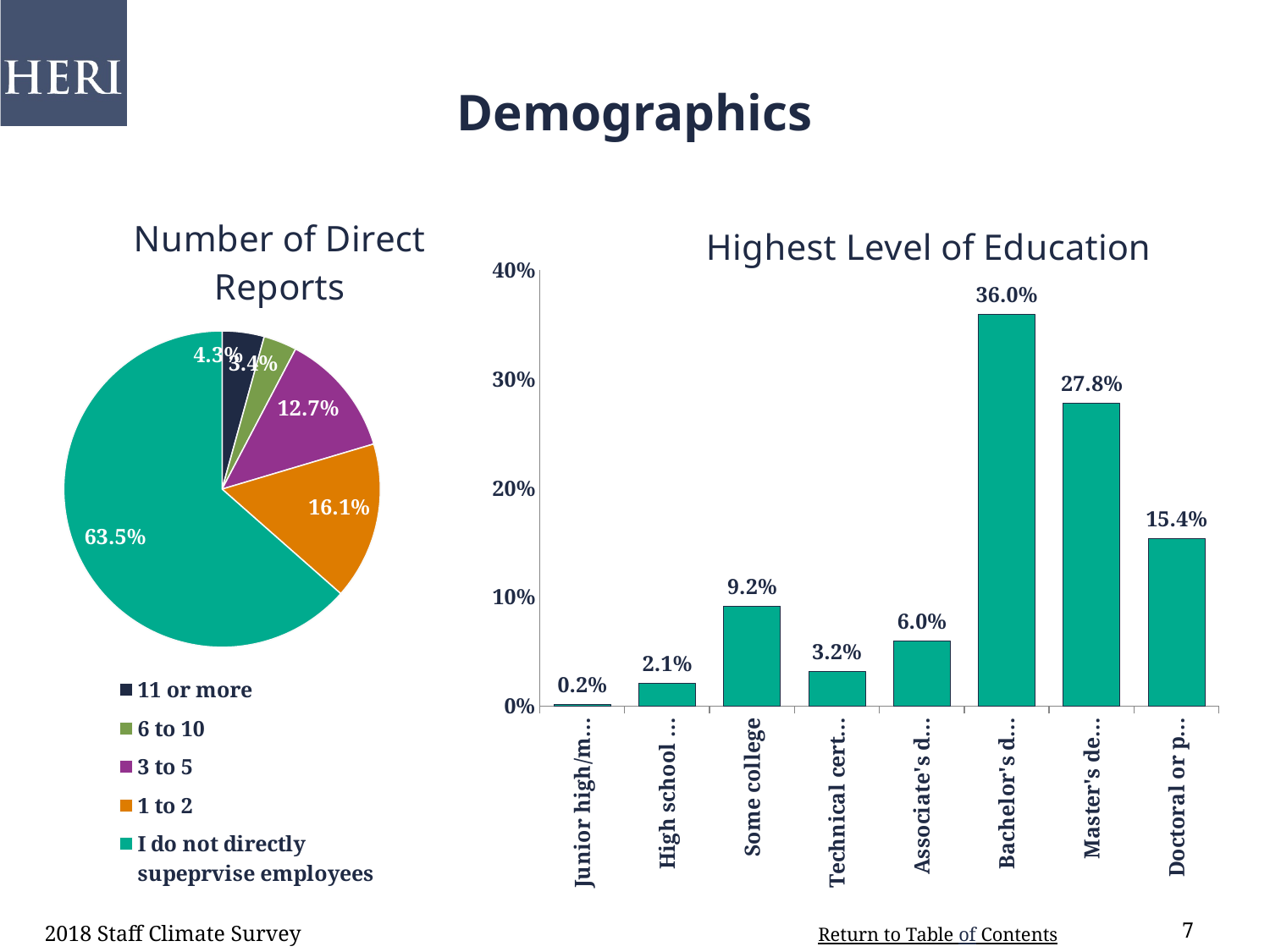
In the Highest Level of Education chart, what is the difference between the Bachelor's and Master's values? 8.2% In the Number of Direct Reports pie chart, what is the difference between the 3 to 5 slice and the 6 to 10 slice? 9.3% In the Highest Level of Education chart, what percentage is shown for Some college? 9.2% In the Highest Level of Education chart, which category has the highest value? Bachelor's degree In the Highest Level of Education chart, is the value for Doctoral or professional greater or less than 20%? less How many categories are shown in the Highest Level of Education chart? 8 What kind of chart is the Highest Level of Education chart? bar chart In the Highest Level of Education chart, which category has the lowest value? Junior high/middle school In the Highest Level of Education chart, which is larger: the value for Associate's or the value for Technical certificate? Associate's In the Number of Direct Reports pie chart, which category has the largest slice? I do not directly supervise employees In the Number of Direct Reports pie chart, what share is shown for 1 to 2? 16.1% How many entries does the legend of the Number of Direct Reports pie chart list? 5